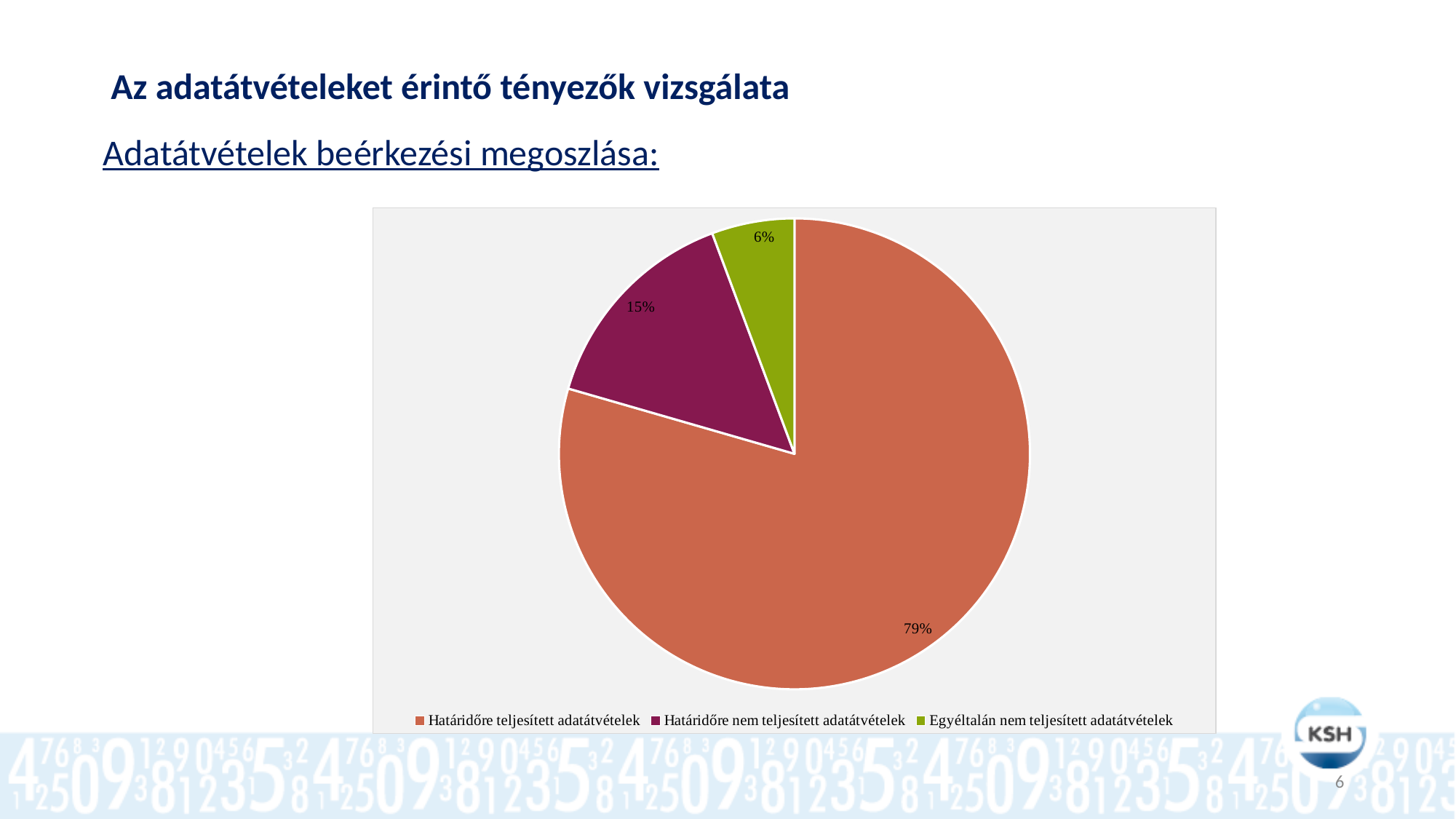
What colour is the slice for "Határidőre teljesített adatátvételek"? orange Which category has the smallest slice of the pie? Egyáltalán nem teljesített adatátvételek Which is larger: the "Határidőre nem teljesített adatátvételek" slice or the "Egyáltalán nem teljesített adatátvételek" slice? Határidőre nem teljesített adatátvételek What is the difference in percentage points between the "Határidőre nem teljesített adatátvételek" slice and the "Egyáltalán nem teljesített adatátvételek" slice? 9 percentage points What share of the pie is labelled "Határidőre teljesített adatátvételek"? 79% What kind of chart is shown on the slide? pie chart How many slices does the pie chart have? 3 Which category has the largest slice of the pie? Határidőre teljesített adatátvételek What share of the pie is labelled "Határidőre nem teljesített adatátvételek"? 15% What share of the pie is labelled "Egyáltalán nem teljesített adatátvételek"? 6% What is the underlined heading above the chart? Adatátvételek beérkezési megoszlása: How many entries does the legend list? 3